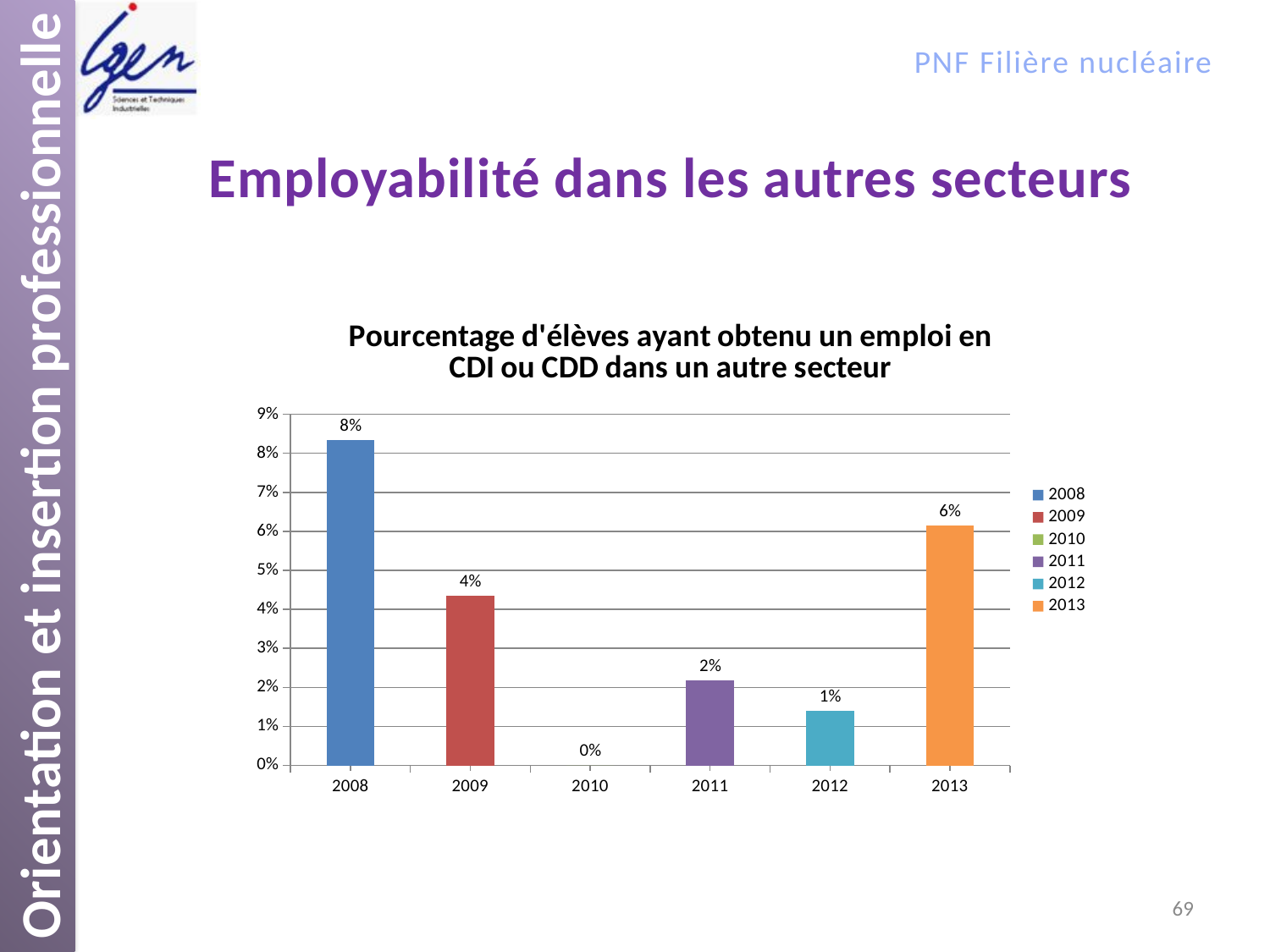
How many years are shown on the x axis? 6 Which year has the lowest value? 2010 What is the title of the chart? Pourcentage d'élèves ayant obtenu un emploi en CDI ou CDD dans un autre secteur Which is larger, the value for 2009 or the value for 2011? 2009 What is the value for 2008? 8% What is the value for 2010? 0% What is the value for 2013? 6% How many entries does the legend list? 6 What is the value for 2012? 1% What is the difference between the values for 2008 and 2013? 2% Which year has the highest value? 2008 What kind of chart is shown? bar chart